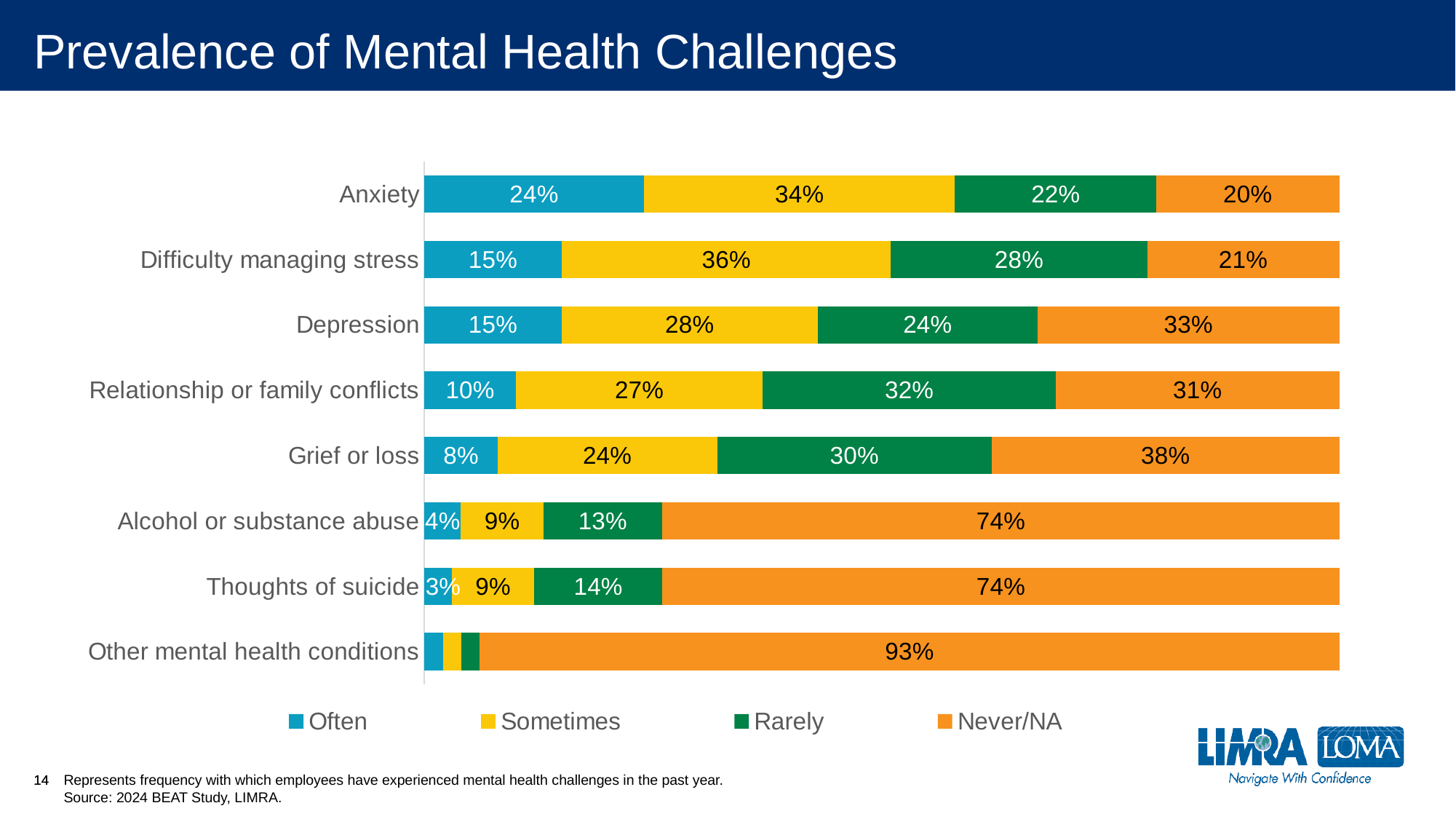
Which category has the highest 'Never/NA' value? Other mental health conditions Which is larger: the 'Rarely' value for Relationship or family conflicts or the 'Rarely' value for Depression? Relationship or family conflicts What percentage of employees reported experiencing anxiety 'Often'? 24% Which category has the highest 'Often' value? Anxiety Which category has the lowest 'Rarely' value among those with a printed label? Alcohol or substance abuse What is the difference between the 'Never/NA' values for Depression and Anxiety? 13% Which legend entry is shown in orange? Never/NA How many series does the legend list? 4 What is the 'Never/NA' value for Grief or loss? 38% What type of chart is shown on the slide? Stacked bar chart What is the 'Sometimes' value for Difficulty managing stress? 36% How many mental health challenge categories are shown in the chart? 8